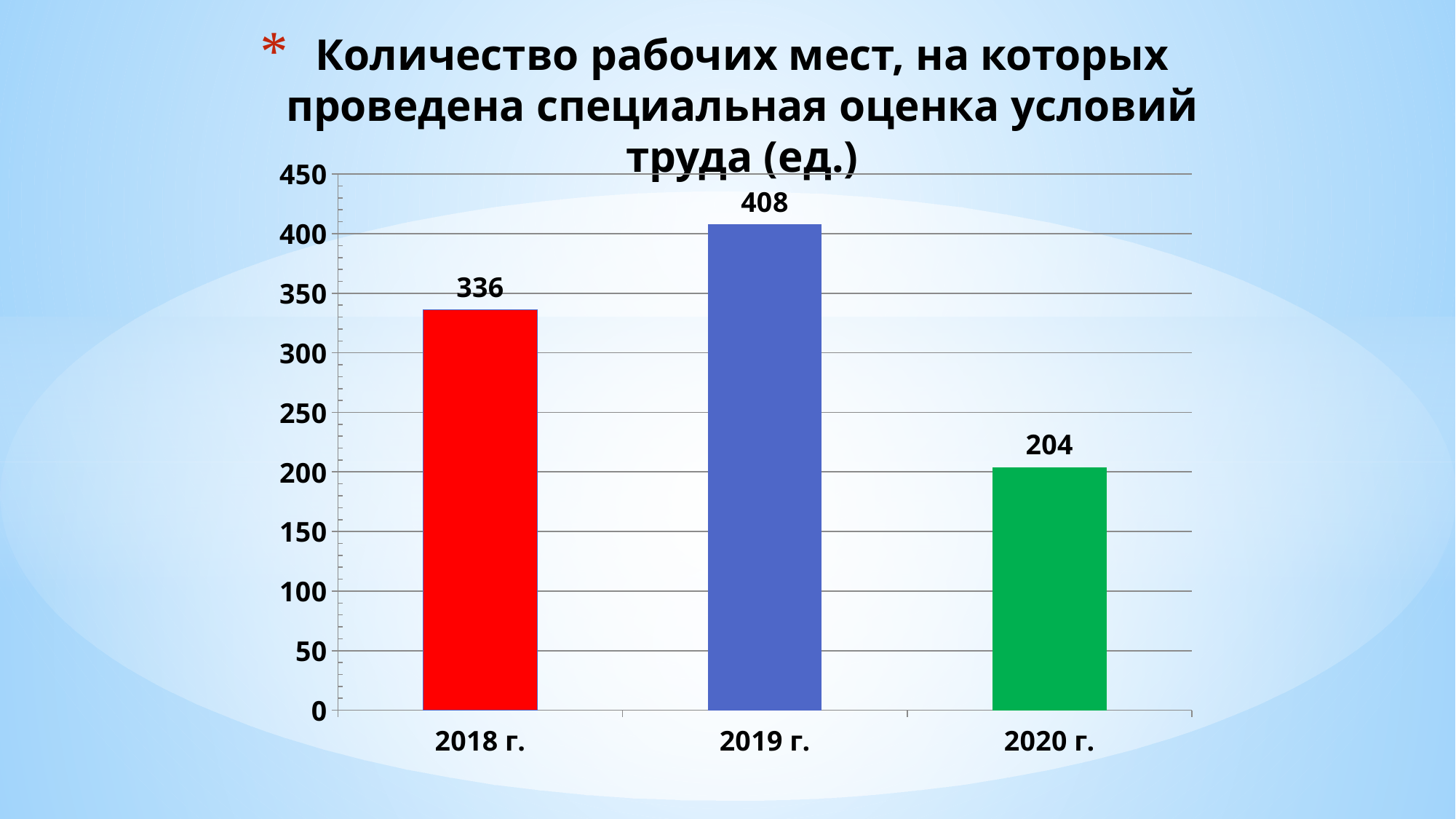
What kind of chart is shown on the slide? bar chart Which year has the highest value? 2019 г. What is the value for 2018 г.? 336 What colour is the bar for 2020 г.? green What is the difference between the values for 2018 г. and 2020 г.? 132 Which year has the lowest value? 2020 г. Is the value for 2019 г. greater or less than 400? greater How many years are shown on the x axis? 3 What is the value for 2020 г.? 204 What is the value for 2019 г.? 408 What is the difference between the values for 2019 г. and 2018 г.? 72 Which is larger, the value for 2018 г. or the value for 2020 г.? 2018 г.